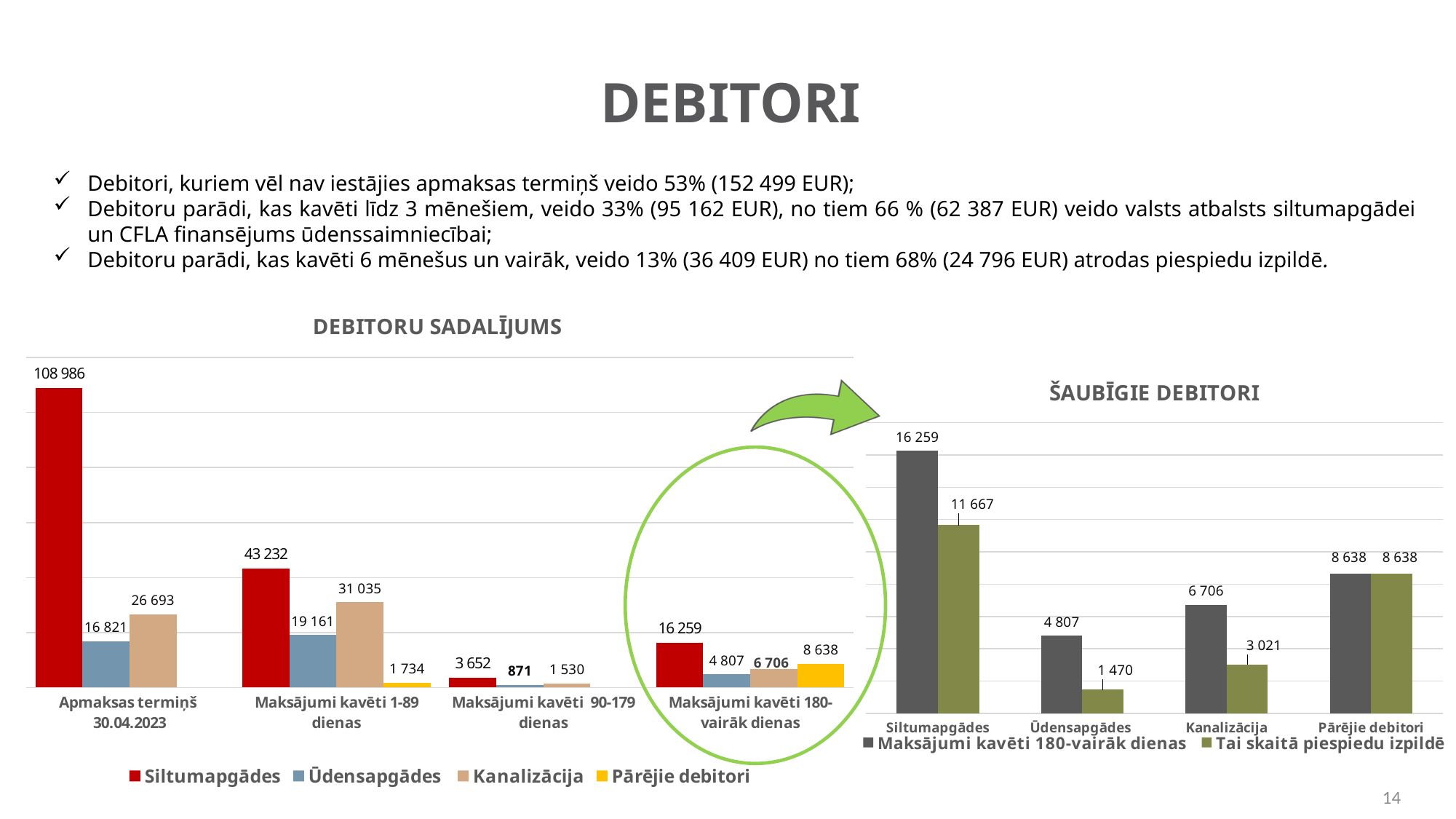
In the DEBITORU SADALĪJUMS chart, which series has the lowest value in the Maksājumi kavēti 90-179 dienas category? Ūdensapgādes In the ŠAUBĪGIE DEBITORI chart, what is the value of Tai skaitā piespiedu izpildē for Siltumapgādes? 11 667 In the DEBITORU SADALĪJUMS chart, how many series does the legend list? 4 In the DEBITORU SADALĪJUMS chart, how many categories are shown on the x axis? 4 In the DEBITORU SADALĪJUMS chart, what is the value for Siltumapgādes in the Apmaksas termiņš 30.04.2023 category? 108 986 In the ŠAUBĪGIE DEBITORI chart, what is the difference between the two series for Kanalizācija? 3 685 In the DEBITORU SADALĪJUMS chart, which is larger in the Maksājumi kavēti 180-vairāk dienas category: Kanalizācija or Pārējie debitori? Pārējie debitori In the DEBITORU SADALĪJUMS chart, what is the difference between Siltumapgādes and Ūdensapgādes in the Maksājumi kavēti 1-89 dienas category? 24 071 In the ŠAUBĪGIE DEBITORI chart, which category has the highest value for Maksājumi kavēti 180-vairāk dienas? Siltumapgādes What type of chart is ŠAUBĪGIE DEBITORI? Bar chart In the DEBITORU SADALĪJUMS chart, what is the value for Kanalizācija in the Maksājumi kavēti 1-89 dienas category? 31 035 In the ŠAUBĪGIE DEBITORI chart, what colour are the bars for Tai skaitā piespiedu izpildē? Olive green